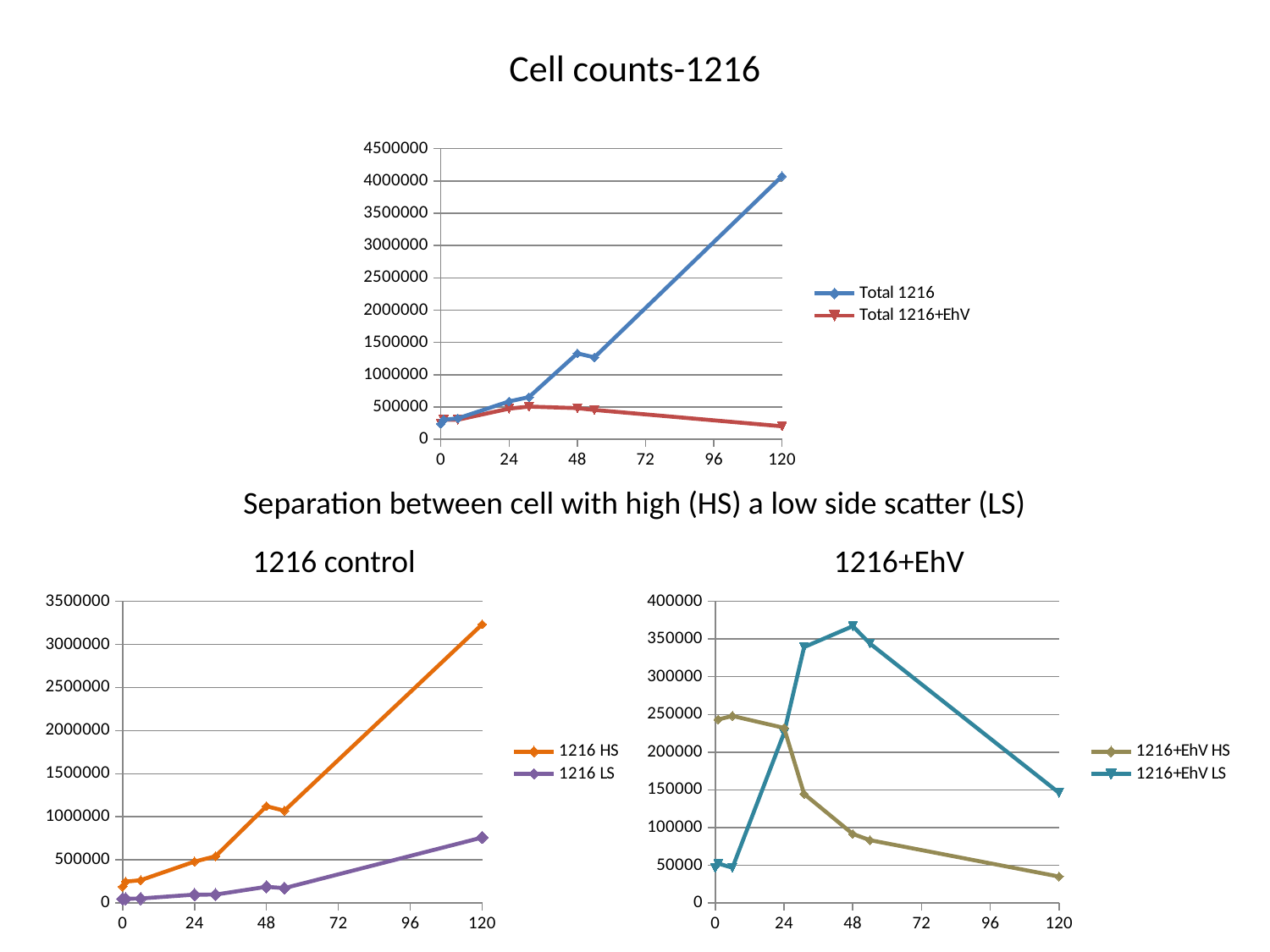
In the '1216+EhV' chart, at which x-axis value does the 1216+EhV LS series reach its highest point? 48 In the '1216 control' chart, which series has the higher value at 120, 1216 HS or 1216 LS? 1216 HS In the '1216 control' chart, is the value for 1216 HS at 120 greater or less than 3000000? greater In the 'Cell counts-1216' chart, is the value for Total 1216+EhV at 120 greater or less than 500000? less In the 'Cell counts-1216' chart, is the value for Total 1216 at 120 greater or less than 3500000? greater In the 'Cell counts-1216' chart, which series has the higher value at 120, Total 1216 or Total 1216+EhV? Total 1216 In the 'Cell counts-1216' chart, how many series does the legend list? 2 In the 'Cell counts-1216' chart, what kind of chart is shown? line chart In the 'Cell counts-1216' chart, does the Total 1216 series rise or fall overall from 0 to 120? rise